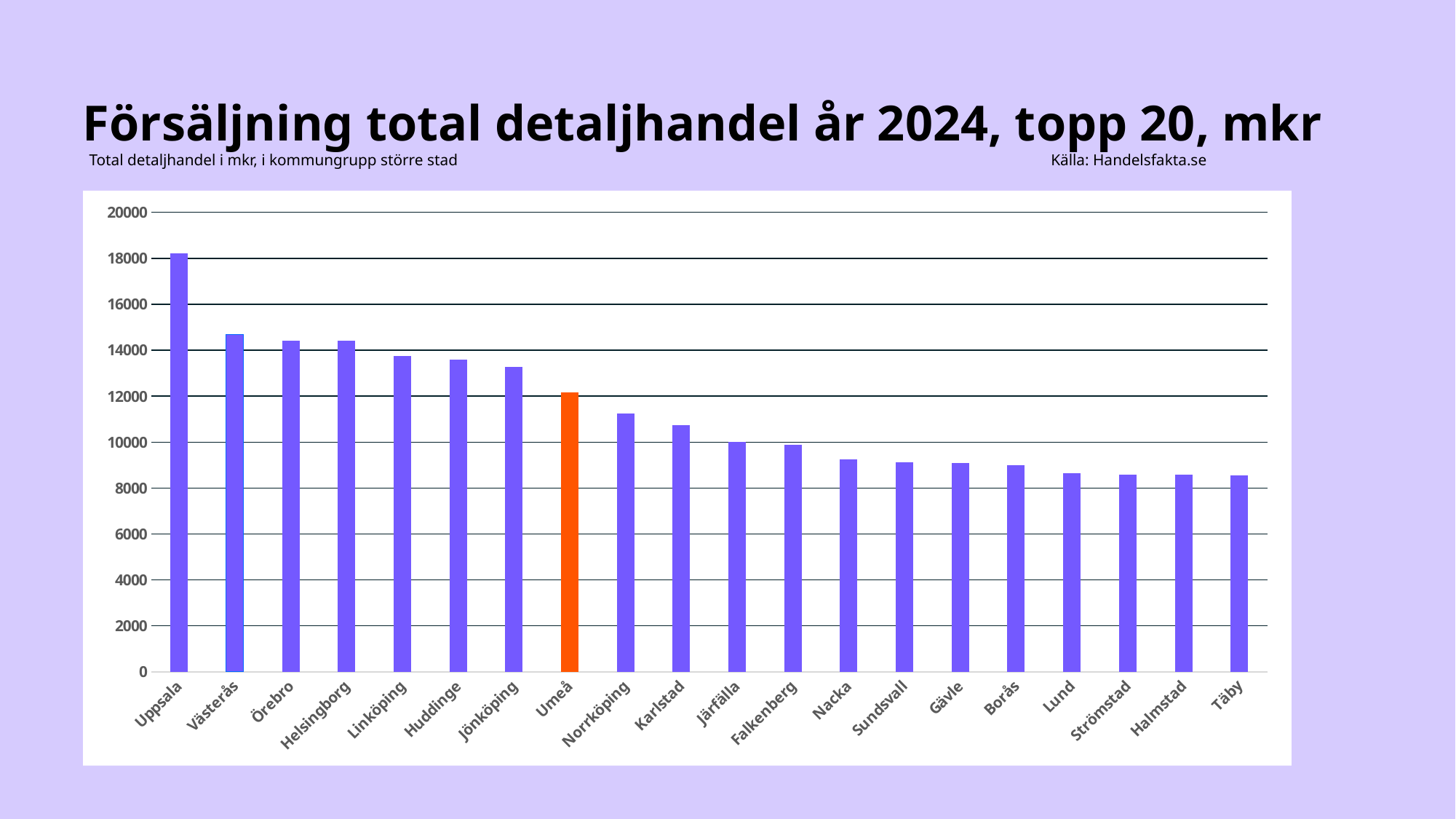
What kind of chart is shown on the slide? bar chart Which is larger, the value for Umeå or the value for Norrköping? Umeå How many municipalities are shown on the x axis? 20 Is the value for Norrköping greater or less than 10000? greater Is the value for Linköping greater or less than 14000? less Which municipality's bar is highlighted in orange? Umeå Which is larger, the value for Jönköping or the value for Umeå? Jönköping Is the value for Täby greater or less than 10000? less Do the values rise or fall from left to right along the x axis? fall Which municipality has the highest total retail sales in the chart? Uppsala